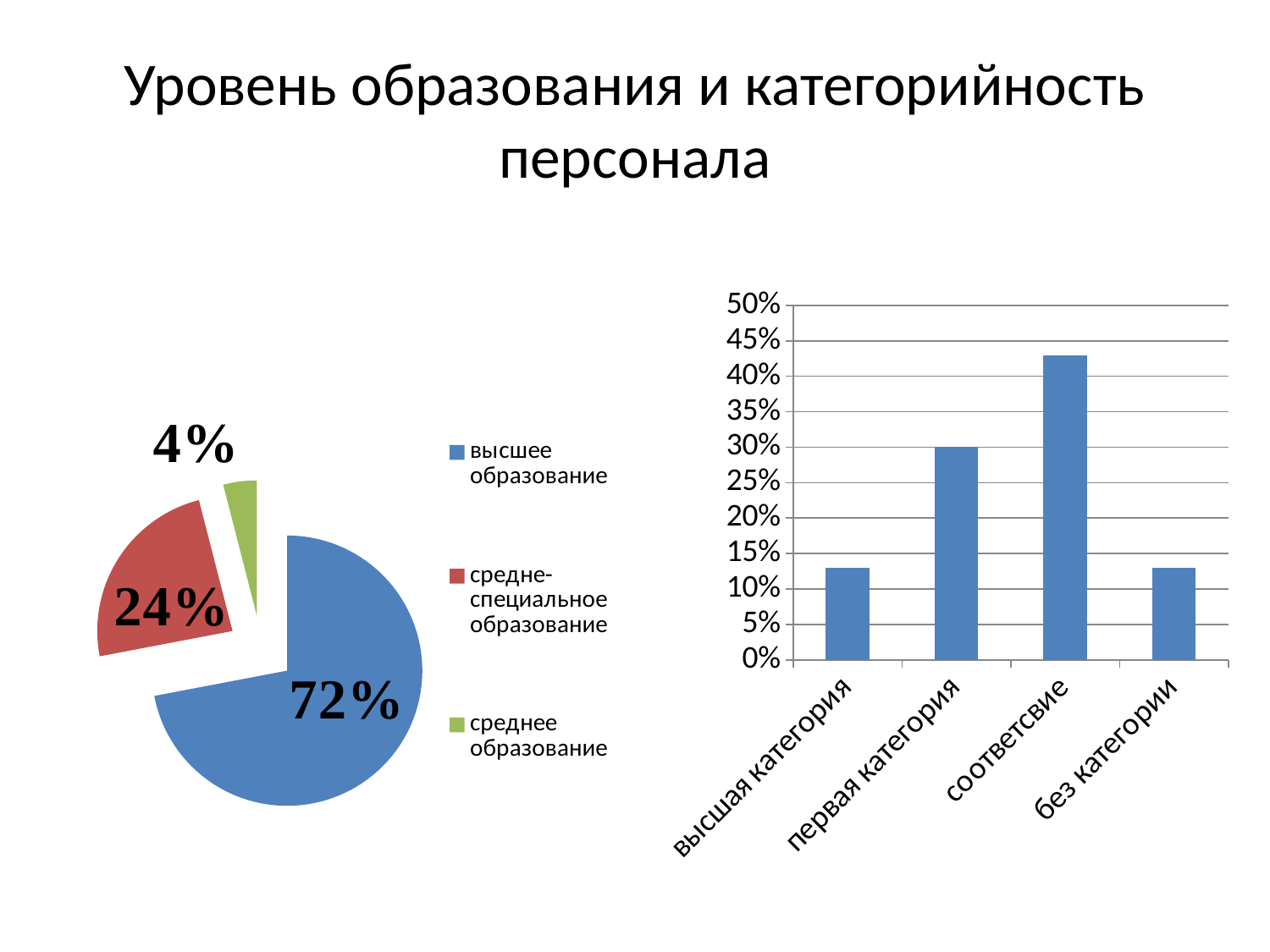
On the bar chart on the right, which category has the highest bar? соответсвие On the bar chart on the right, is the value for соответствие greater or less than 40%? greater On the pie chart on the left, what share does среднее образование have? 4% On the pie chart on the left, what share does средне-специальное образование have? 24% On the pie chart on the left, which category has the largest slice? высшее образование On the pie chart on the left, what share does высшее образование have? 72% On the pie chart on the left, which category has the smallest slice? среднее образование On the bar chart on the right, is the value for высшая категория greater or less than 15%? less On the pie chart on the left, what is the difference between the shares of высшее образование and средне-специальное образование? 48% On the bar chart on the right, how many categories are shown on the x axis? 4 On the pie chart on the left, how many slices are there? 3 On the bar chart on the right, what is the value for первая категория? 30%